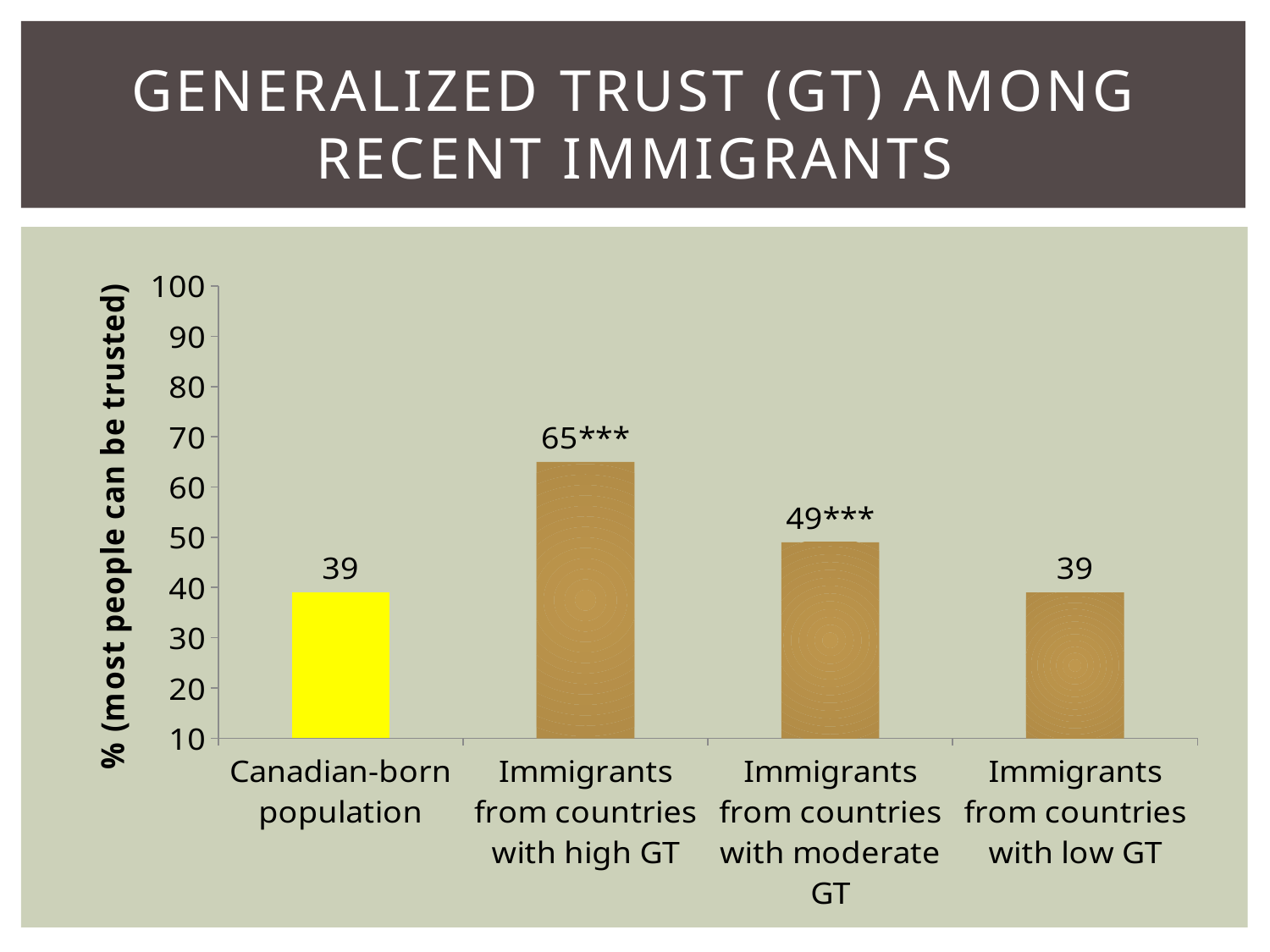
How many categories are shown on the x axis? 4 What is the difference between the value for immigrants from countries with high GT and the Canadian-born population? 26 What is the value shown for immigrants from countries with high GT? 65*** What kind of chart is shown on the slide? Bar chart What is the value for the Canadian-born population? 39 Which is larger: the value for immigrants from countries with moderate GT or the value for immigrants from countries with low GT? Immigrants from countries with moderate GT What is the label of the vertical axis? % (most people can be trusted) What is the value for immigrants from countries with low GT? 39 Which category has the highest value? Immigrants from countries with high GT What is the value shown for immigrants from countries with moderate GT? 49*** What is the difference between the values for immigrants from countries with high GT and immigrants from countries with moderate GT? 16 Is the value for immigrants from countries with high GT greater or less than 60? greater